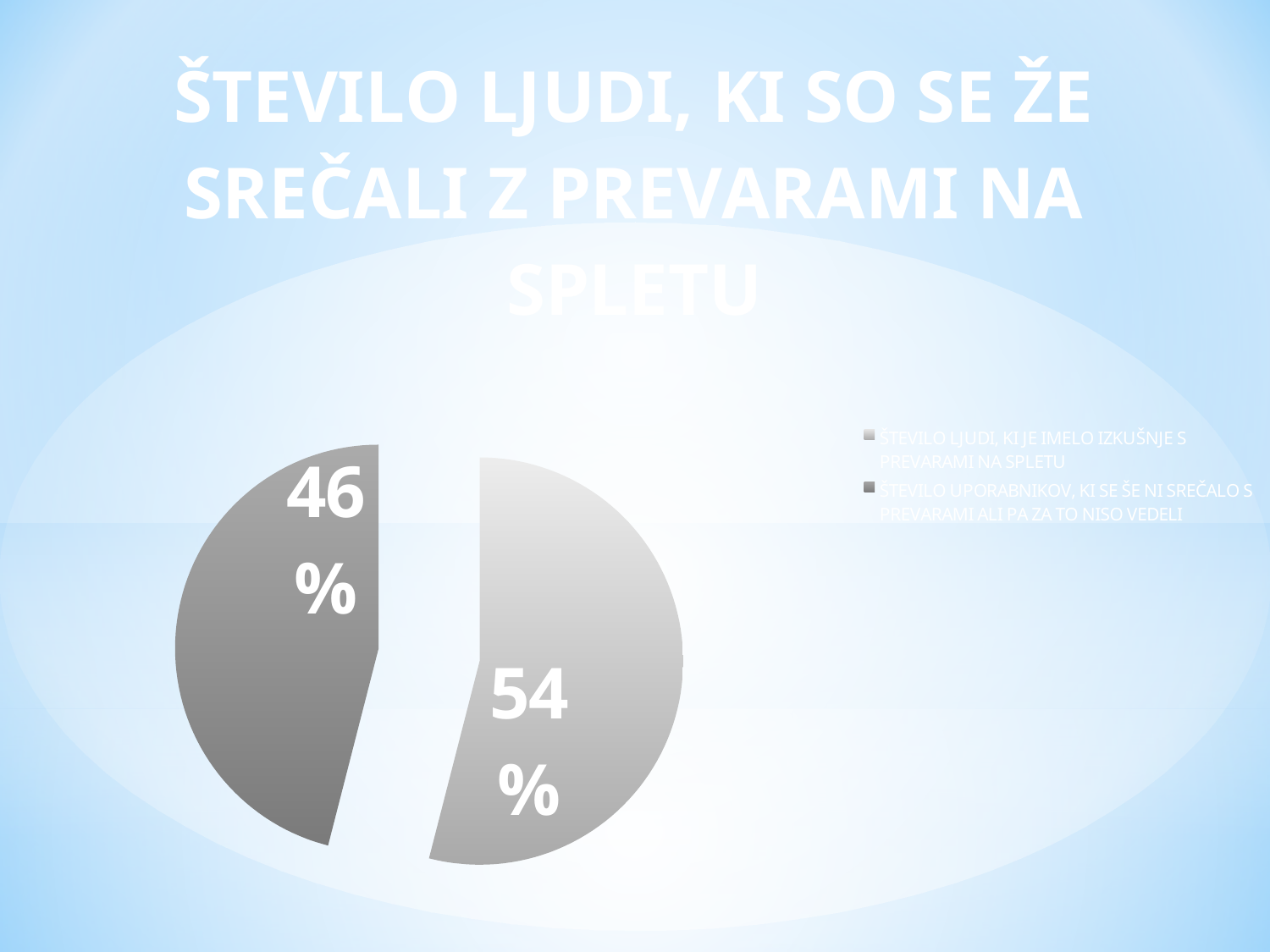
What is the first legend entry of the pie chart? ŠTEVILO LJUDI, KI JE IMELO IZKUŠNJE S PREVARAMI NA SPLETU Is the value of the larger slice of the pie chart greater or less than 50%? greater What percentage is shown on the smaller slice of the pie chart? 46% What percentage is shown on the larger slice of the pie chart? 54% Which slice of the pie chart is larger, the 46% slice or the 54% slice? the 54% slice What is the difference in percentage points between the two slices of the pie chart? 8 How many entries does the legend of the pie chart list? 2 How many slices does the pie chart have? 2 What share of the pie is labelled for the light grey slice (ŠTEVILO LJUDI, KI JE IMELO IZKUŠNJE S PREVARAMI NA SPLETU)? 54% What share of the pie is labelled for the dark grey slice (ŠTEVILO UPORABNIKOV, KI SE ŠE NI SREČALO S PREVARAMI ALI PA ZA TO NISO VEDELI)? 46% What is the title of the slide containing the pie chart? ŠTEVILO LJUDI, KI SO SE ŽE SREČALI Z PREVARAMI NA SPLETU What kind of chart is shown on the slide? pie chart